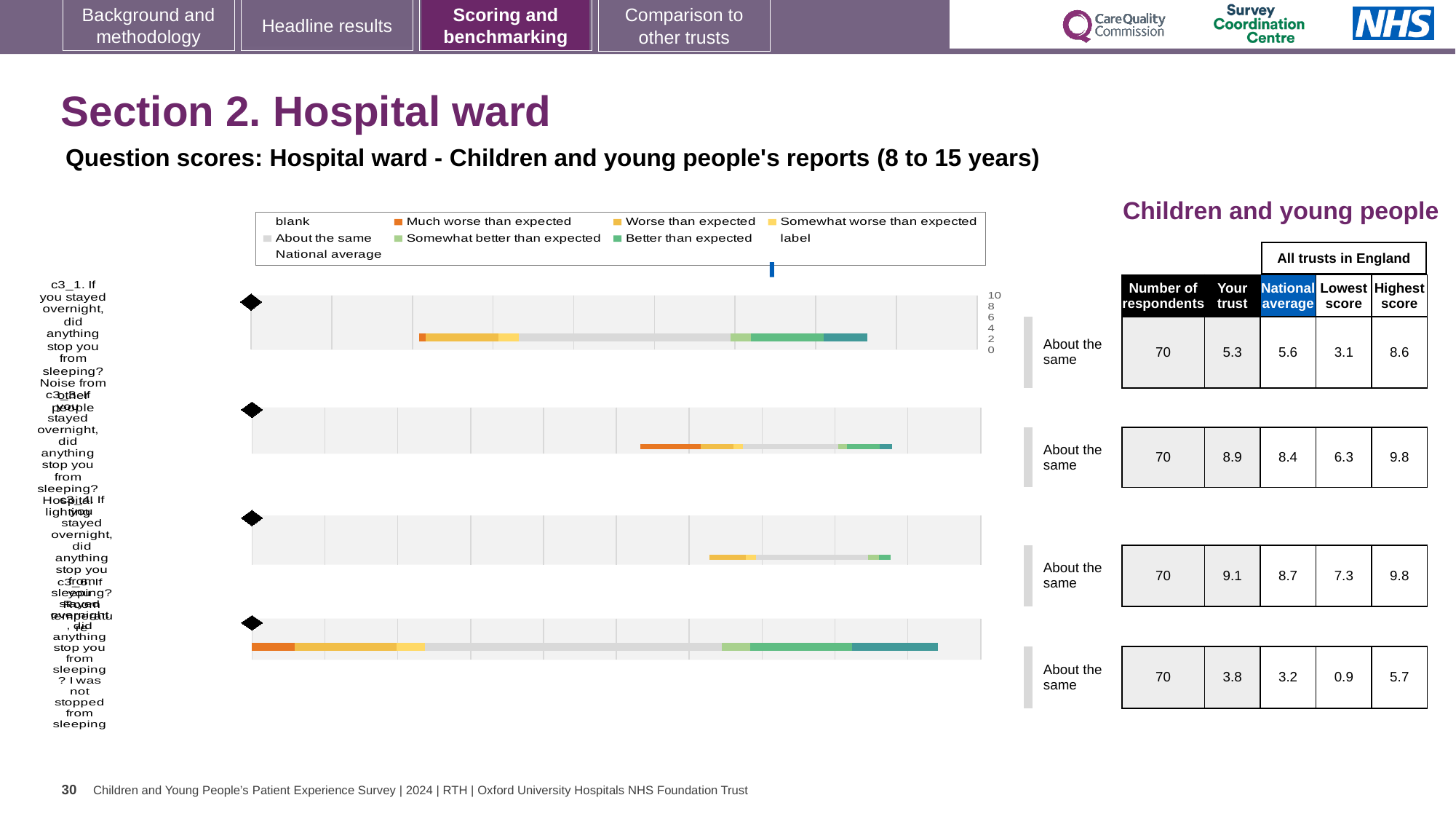
For the first chart (c3_1, noise from other people), what is the 'Your trust' score in the table? 5.3 What kind of chart is used to show the benchmark results on this slide? bar chart For the second chart, what is the 'Your trust' score in the table? 8.9 Which colour does the legend use for 'Much worse than expected'? orange How many entries does the legend above the charts list? 9 For the first chart (c3_1, noise from other people), what is the national average score in the table? 5.6 Which chart has the highest 'Your trust' score in the table: the second or the third? the third (9.1) How many respondents are listed for each of the four questions? 70 For the fourth (bottom) chart, what is the highest score across all trusts in England? 5.7 How many separate benchmark bar charts are shown on the slide? 4 What benchmark rating is shown next to each of the four charts? About the same What is the difference between the 'Your trust' score and the national average for the fourth (bottom) chart? 0.6